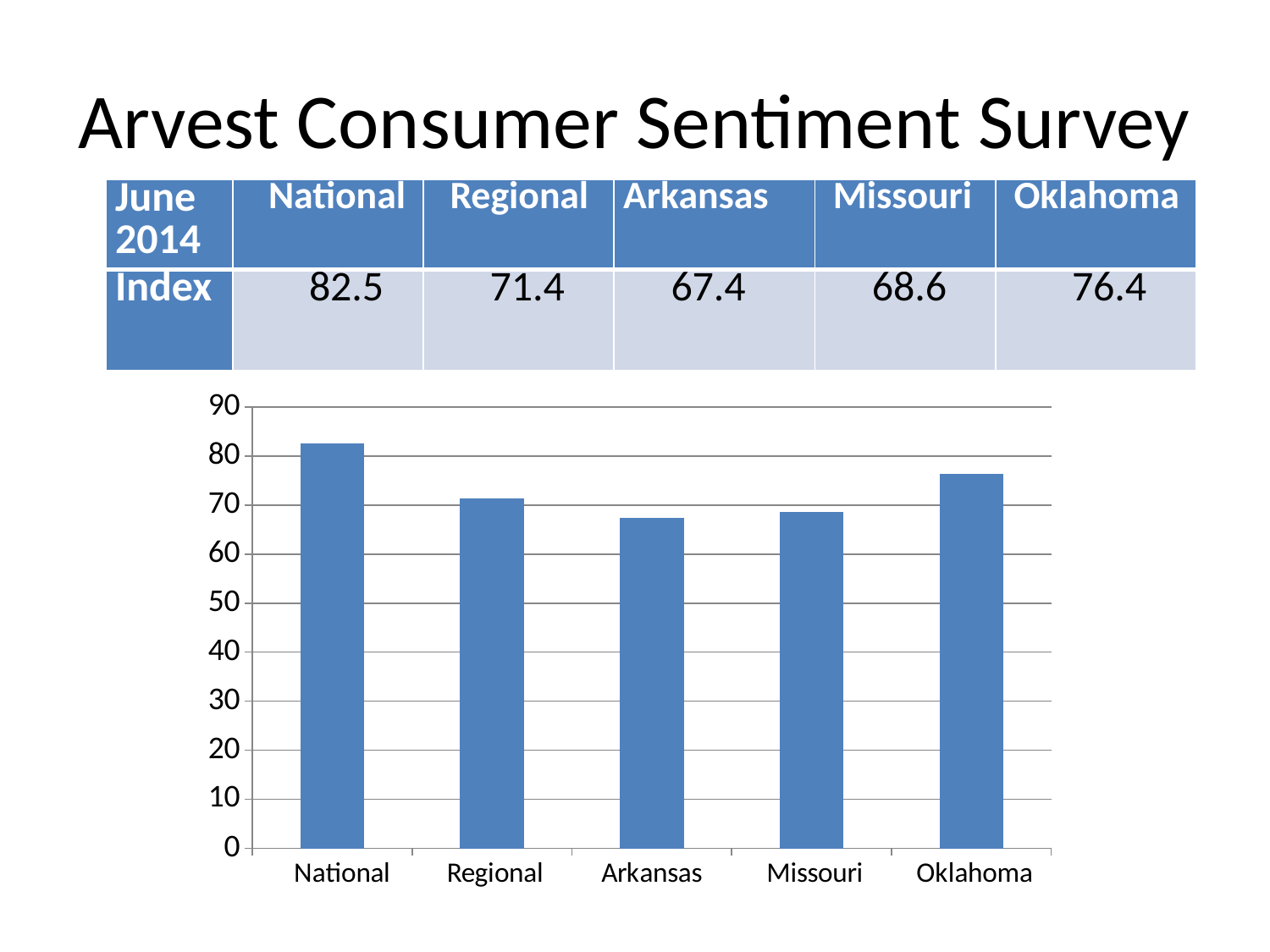
Is the value for Missouri greater or less than 70? less What is the index value for Oklahoma? 76.4 What is the difference between the National and Arkansas index values? 15.1 What is the index value for National in the bar chart? 82.5 How many categories are shown on the x axis of the chart? 5 What is the index value for Arkansas? 67.4 What kind of chart is shown on the slide? bar chart What is the difference between the Oklahoma and Missouri index values? 7.8 Which category has the highest bar in the chart? National Which category has the lowest bar in the chart? Arkansas What is the highest tick value shown on the vertical axis of the chart? 90 Which is larger, the bar for Regional or the bar for Oklahoma? Oklahoma